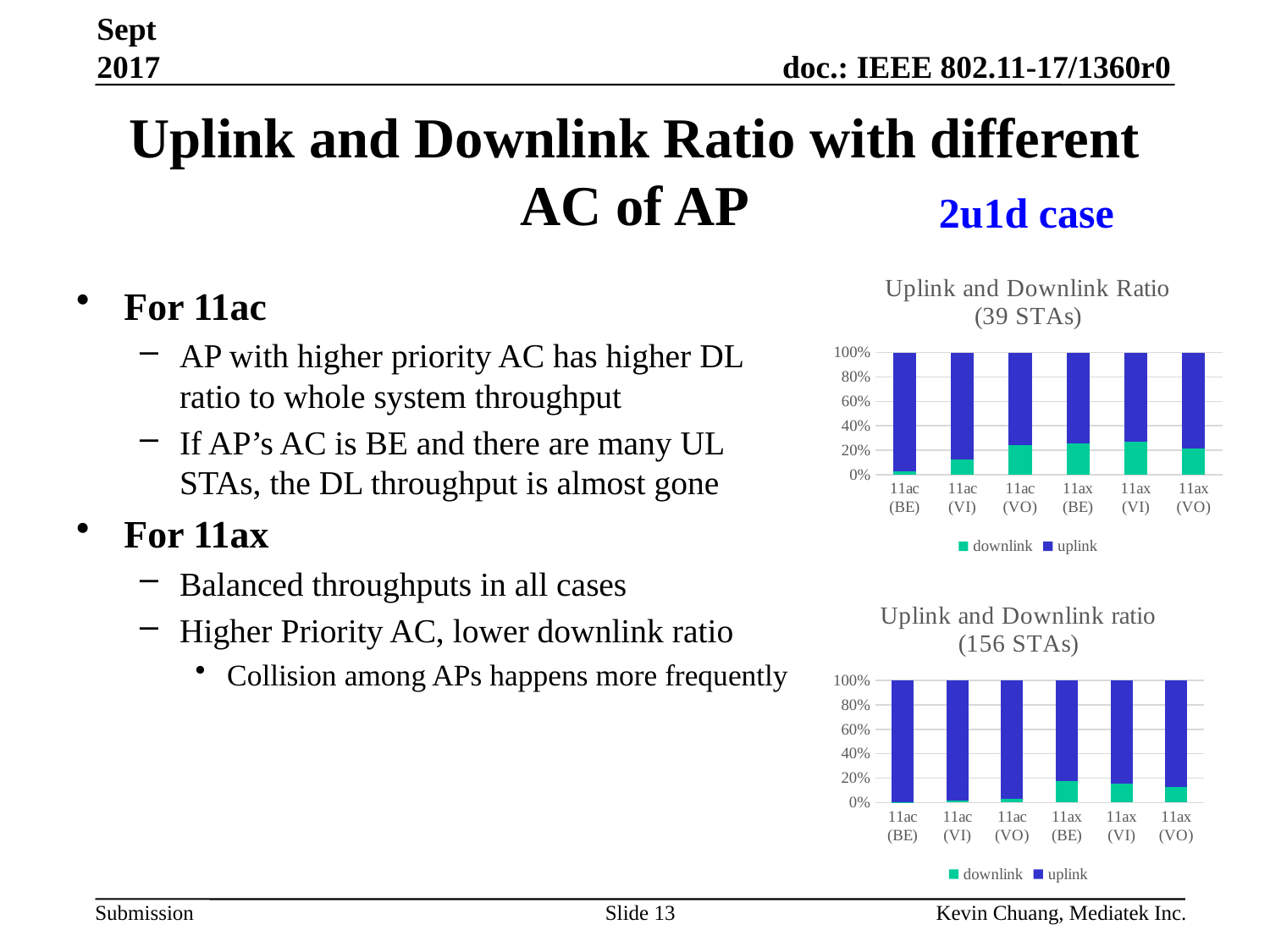
What is the total of the stacked bar for 11ax (VI) in the 'Uplink and Downlink Ratio (39 STAs)' chart? 100% In the 'Uplink and Downlink ratio (156 STAs)' chart, is the uplink share for 11ac (BE) greater or less than 80%? greater In the 'Uplink and Downlink Ratio (39 STAs)' chart, which colour represents the downlink series? green How many series does the legend of the 'Uplink and Downlink ratio (156 STAs)' chart list? 2 In the 'Uplink and Downlink ratio (156 STAs)' chart, which has the larger downlink share, 11ax (BE) or 11ax (VO)? 11ax (BE) In the 'Uplink and Downlink Ratio (39 STAs)' chart, is the downlink share for 11ac (VO) greater or less than 20%? greater In the 'Uplink and Downlink ratio (156 STAs)' chart, is the downlink share for 11ax (BE) greater or less than 20%? less In the 'Uplink and Downlink Ratio (39 STAs)' chart, which category has the lowest downlink share? 11ac (BE) In the 'Uplink and Downlink ratio (156 STAs)' chart, which has the larger downlink share, 11ac (VO) or 11ax (VI)? 11ax (VI) How many categories are shown on the x axis of the 'Uplink and Downlink Ratio (39 STAs)' chart? 6 What kind of chart is the 'Uplink and Downlink Ratio (39 STAs)' chart? stacked bar chart